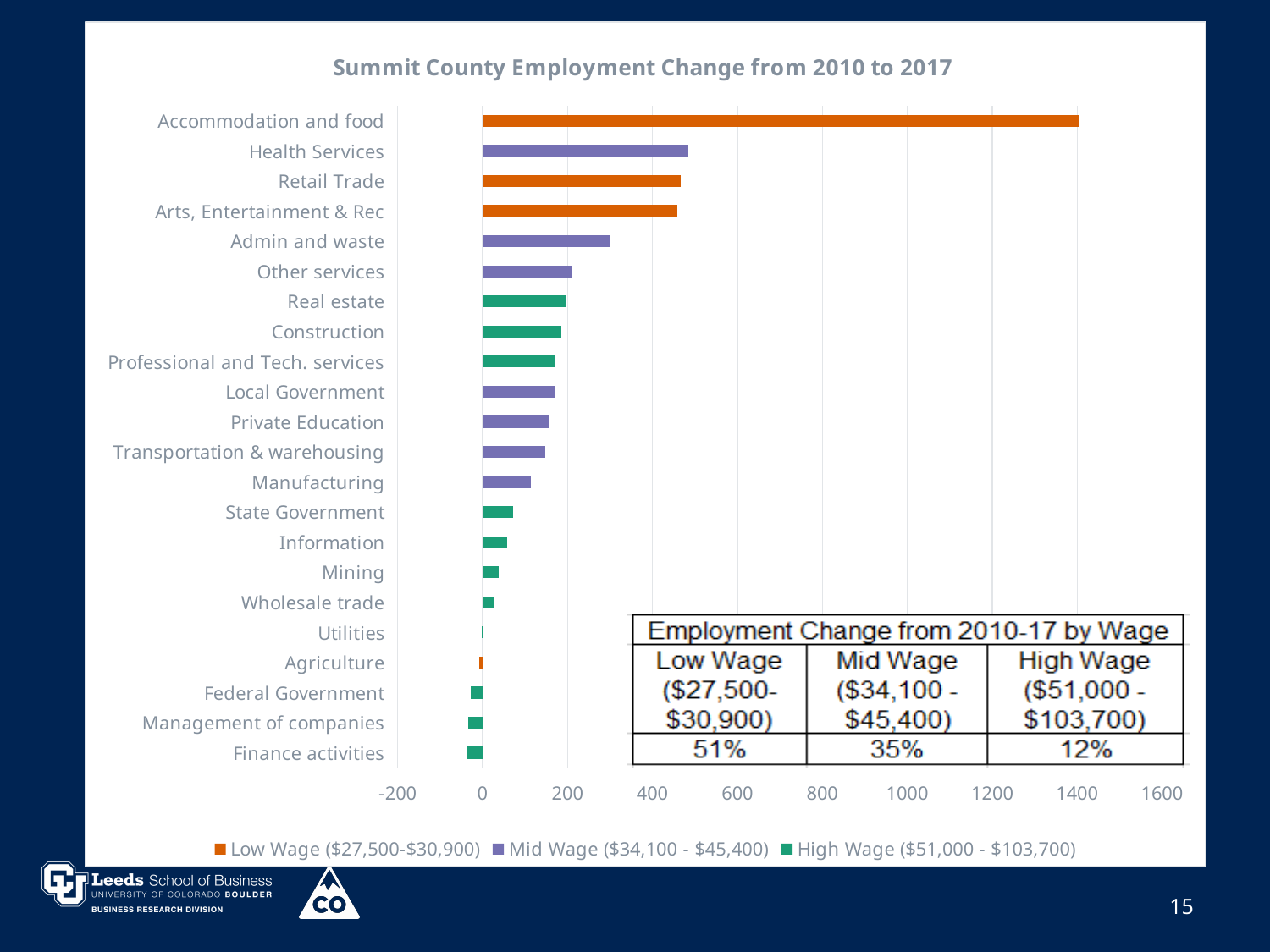
How many series does the legend list? 3 What is the title of the chart? Summit County Employment Change from 2010 to 2017 Is the value for Finance activities greater or less than 0? less Which industry has the highest employment change? Accommodation and food Which wage series does the Accommodation and food bar belong to? Low Wage ($27,500-$30,900) Is the value for Health Services greater or less than 400? greater Which is larger, the value for Admin and waste or the value for Other services? Admin and waste How many industry categories are plotted in the chart? 22 Is the value for Admin and waste greater or less than 200? greater What kind of chart is shown on the slide? bar chart